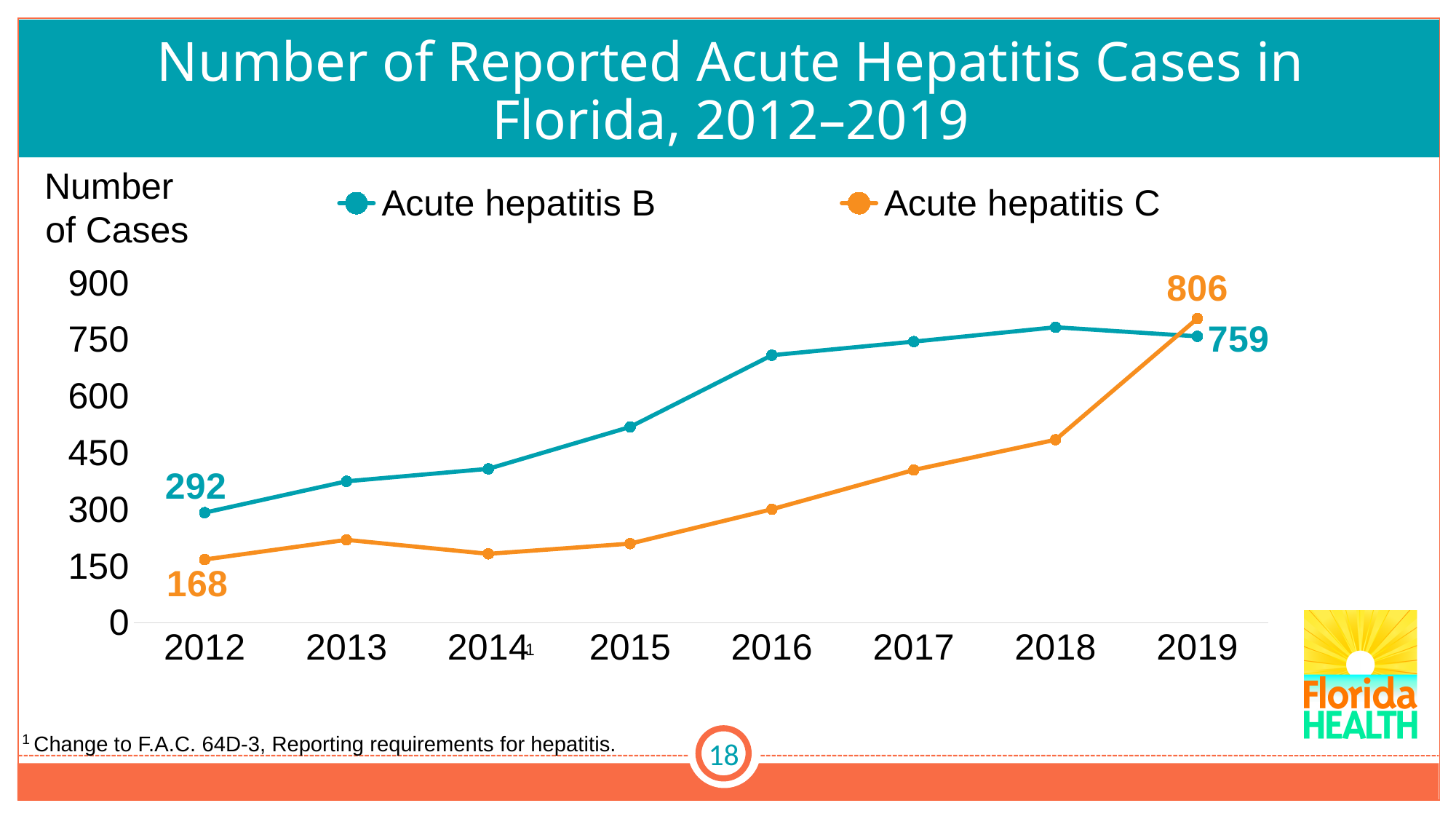
How many acute hepatitis B cases were reported in 2012? 292 How many acute hepatitis C cases were reported in 2019? 806 Do acute hepatitis C cases rise or fall overall from 2012 to 2019? rise What is the difference between acute hepatitis C cases in 2019 and in 2012? 638 In 2019, which series has more reported cases, acute hepatitis B or acute hepatitis C? Acute hepatitis C In which year is the acute hepatitis B value lowest? 2012 Is the value for acute hepatitis B in 2016 greater or less than 600? greater Is the value for acute hepatitis C in 2018 greater or less than 600? less What type of chart is shown on the slide? line chart How many acute hepatitis B cases were reported in 2019? 759 How many series does the legend list? 2 How many years are shown on the x axis? 8